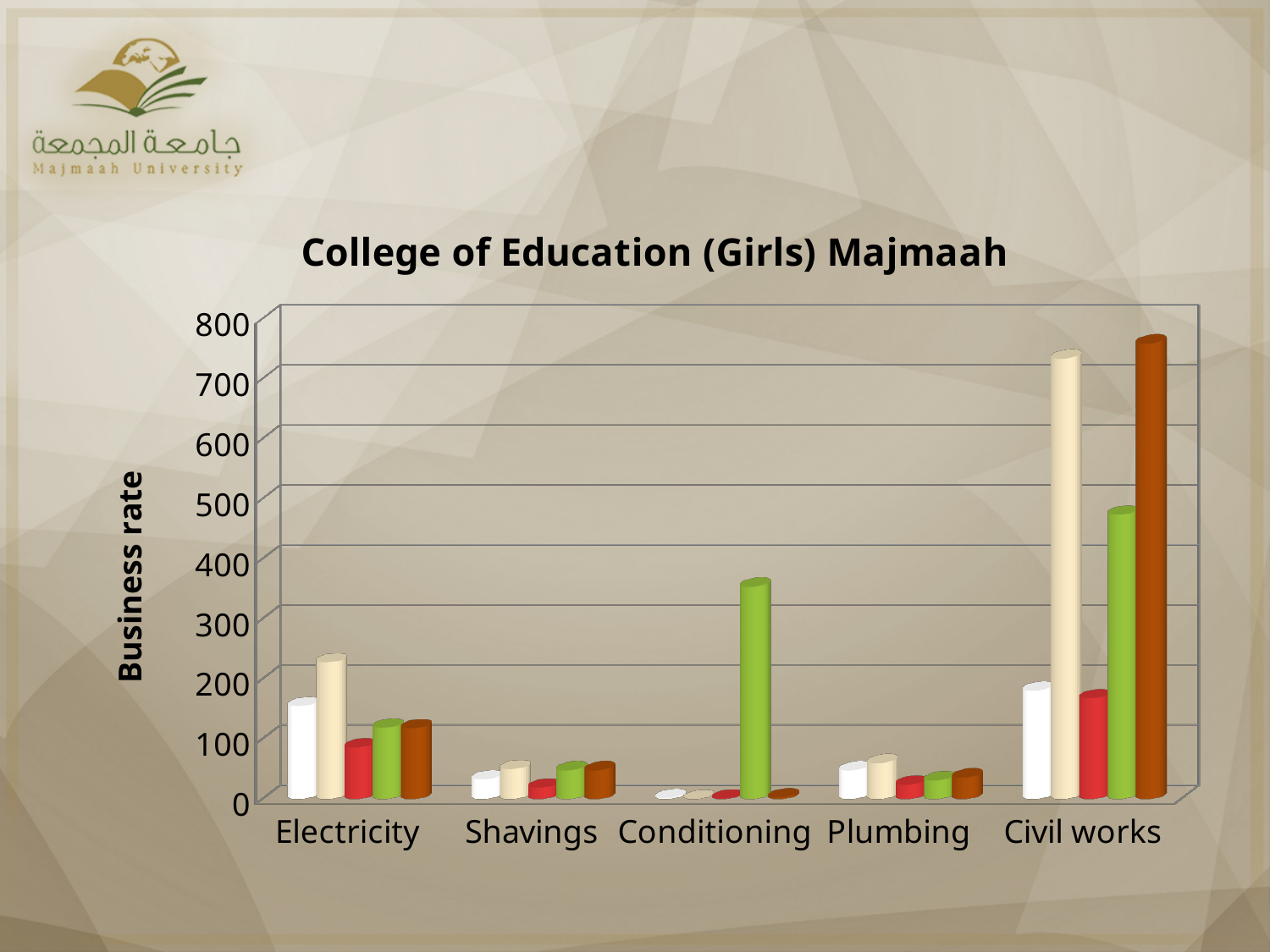
Is the value of the cream bar for Plumbing greater or less than 100? less Is the value of the brown bar for Civil works greater or less than 700? greater Which is larger, the cream bar for Electricity or the cream bar for Shavings? Electricity What kind of chart is shown on the slide? bar chart Which is larger, the green bar for Conditioning or the green bar for Civil works? Civil works What is the title of the chart? College of Education (Girls) Majmaah Is the value of the green bar for Conditioning greater or less than 300? greater What is the label on the vertical axis of the chart? Business rate How many categories are shown on the x axis of the chart? 5 How many bars are plotted for each category in the chart? 5 Which category contains the tallest bar in the chart? Civil works